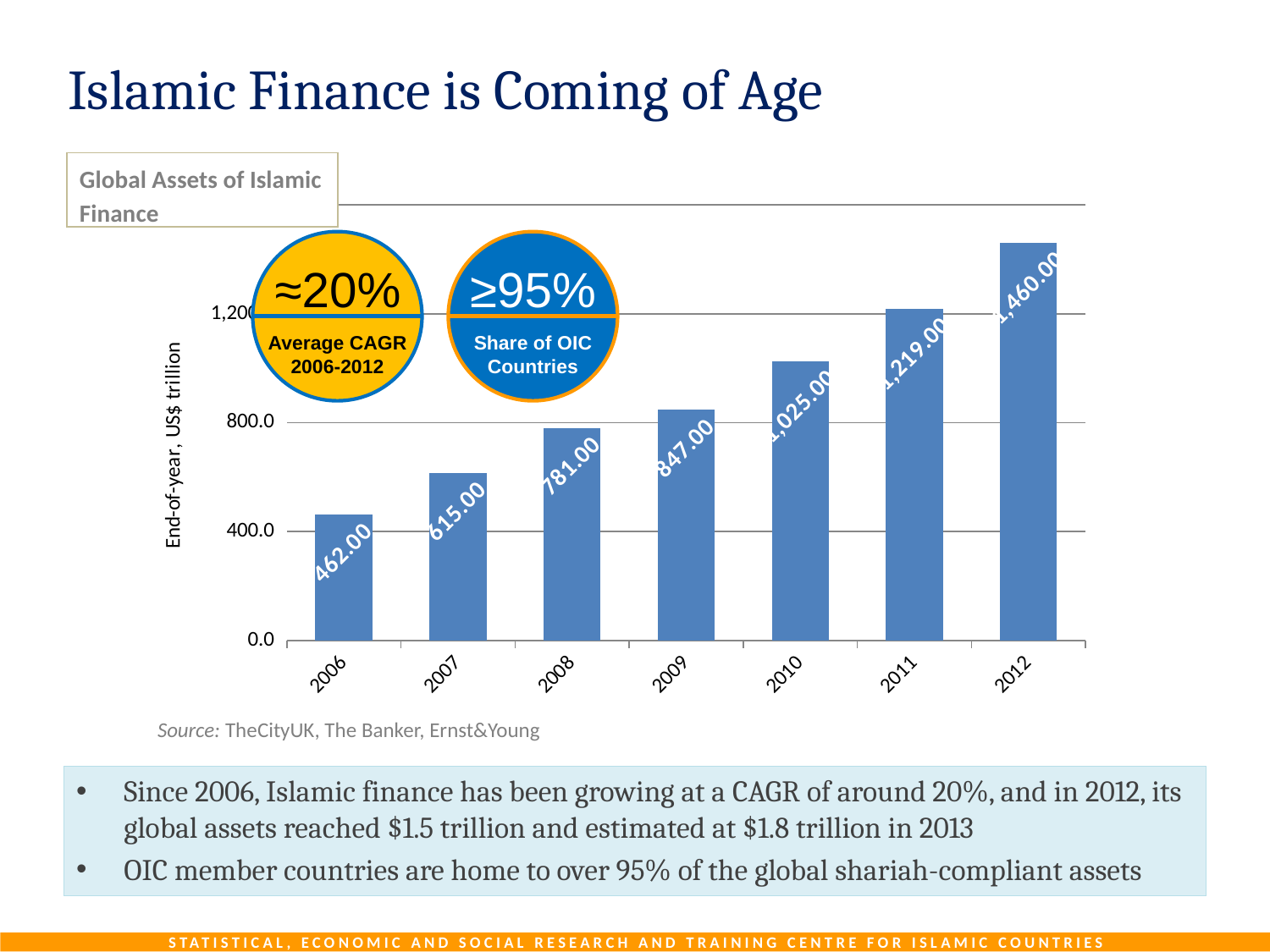
Is the value for 2011 greater or less than 1,200? greater Which year has the highest value in the chart? 2012 What type of chart is shown on the slide? bar chart Which year has the lowest value in the chart? 2006 What is the value for 2009 in the Global Assets of Islamic Finance chart? 847.00 What is the value for 2006 in the Global Assets of Islamic Finance chart? 462.00 What is the value for 2011 in the Global Assets of Islamic Finance chart? 1,219.00 Which is larger, the value for 2009 or the value for 2010? 2010 How many years are plotted in the chart? 7 What is the difference between the values for 2008 and 2007? 166.00 What is the value for 2012 in the Global Assets of Islamic Finance chart? 1,460.00 Do the values rise or fall from 2006 to 2012? rise